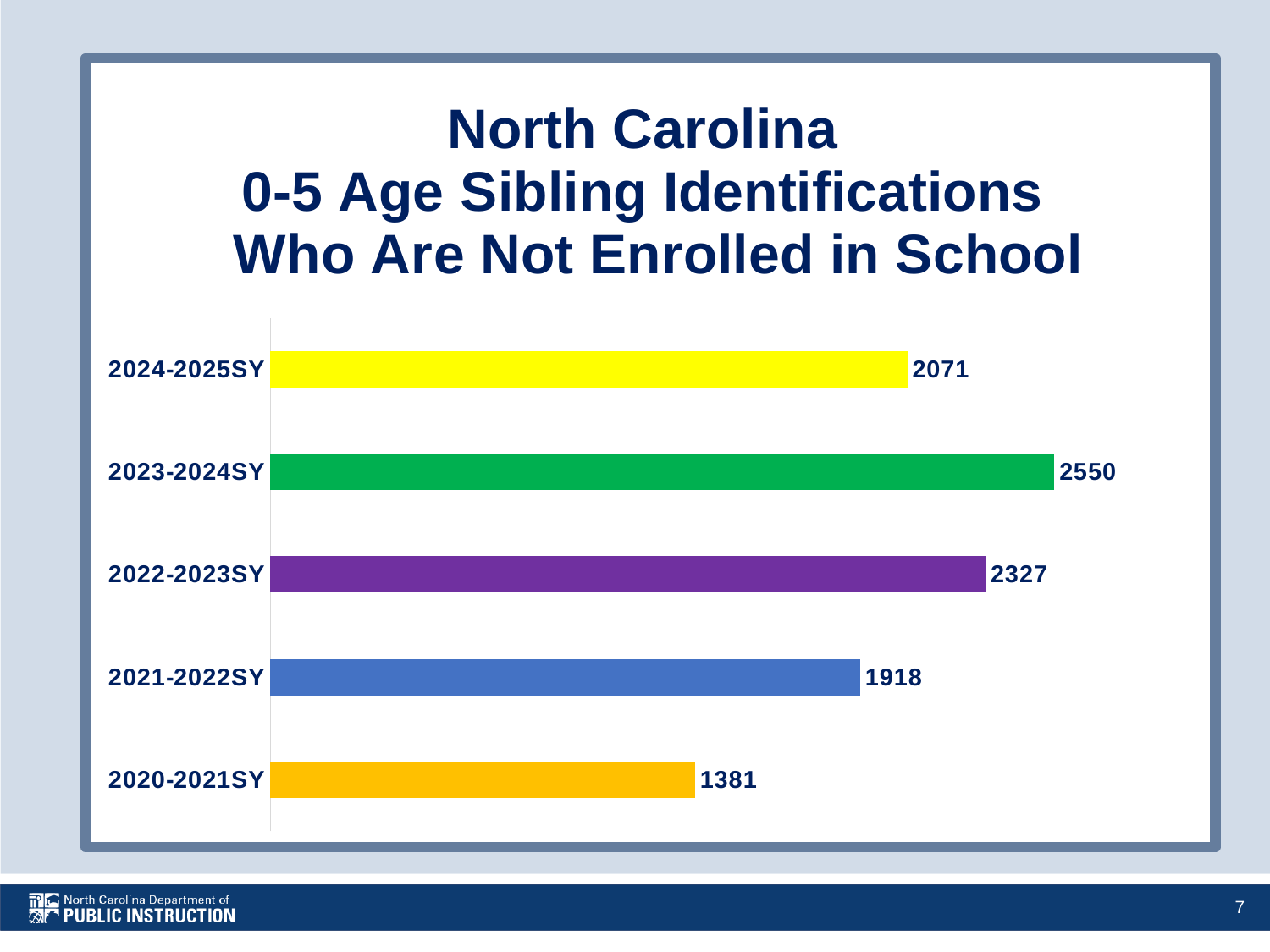
What kind of chart is shown on the slide? Bar chart What is the difference between the values for 2021-2022SY and 2020-2021SY? 537 How many school years are shown in the chart? 5 Which is larger, the value for 2024-2025SY or the value for 2021-2022SY? 2024-2025SY Did the value rise or fall from 2023-2024SY to 2024-2025SY? Fall Which school year has the highest value? 2023-2024SY Which school year has the lowest value? 2020-2021SY What is the value for 2024-2025SY? 2071 What colour is the bar for 2023-2024SY? Green What is the difference between the values for 2023-2024SY and 2022-2023SY? 223 What is the value for 2022-2023SY? 2327 What is the value for 2020-2021SY? 1381